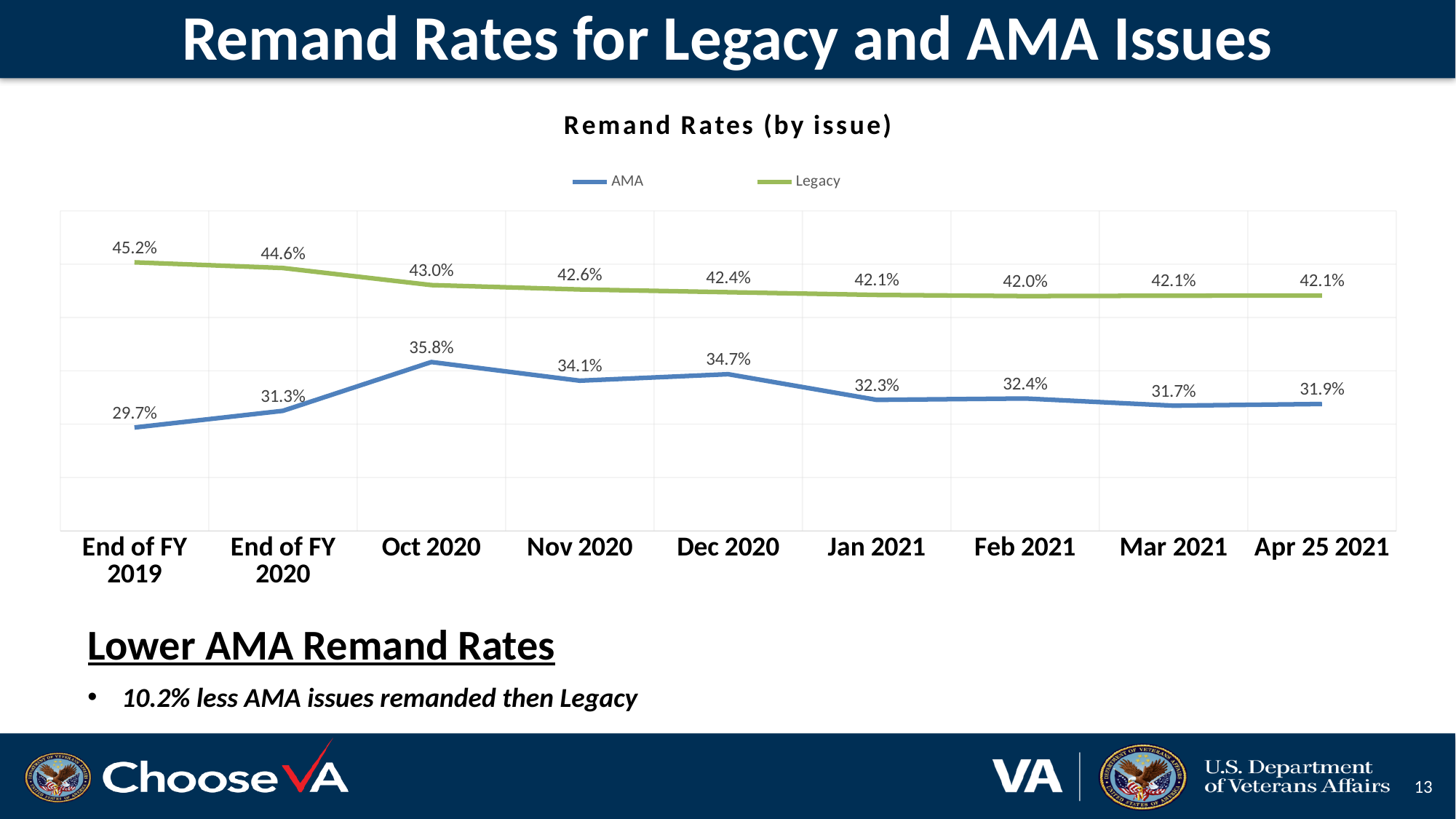
At which point is the Legacy remand rate lowest? Feb 2021 What is the difference between the Legacy and AMA remand rates at End of FY 2019? 15.5% How many series does the legend list? 2 What is the Legacy remand rate in Dec 2020? 42.4% Which series has the higher remand rate in Jan 2021, AMA or Legacy? Legacy At which point is the AMA remand rate highest? Oct 2020 What is the AMA remand rate at End of FY 2019? 29.7% What is the title of the chart? Remand Rates (by issue) How many time points are plotted on the x axis? 9 What kind of chart is shown? Line chart What is the AMA remand rate for Apr 25 2021? 31.9% Does the Legacy remand rate generally rise or fall from End of FY 2019 to Apr 25 2021? Fall